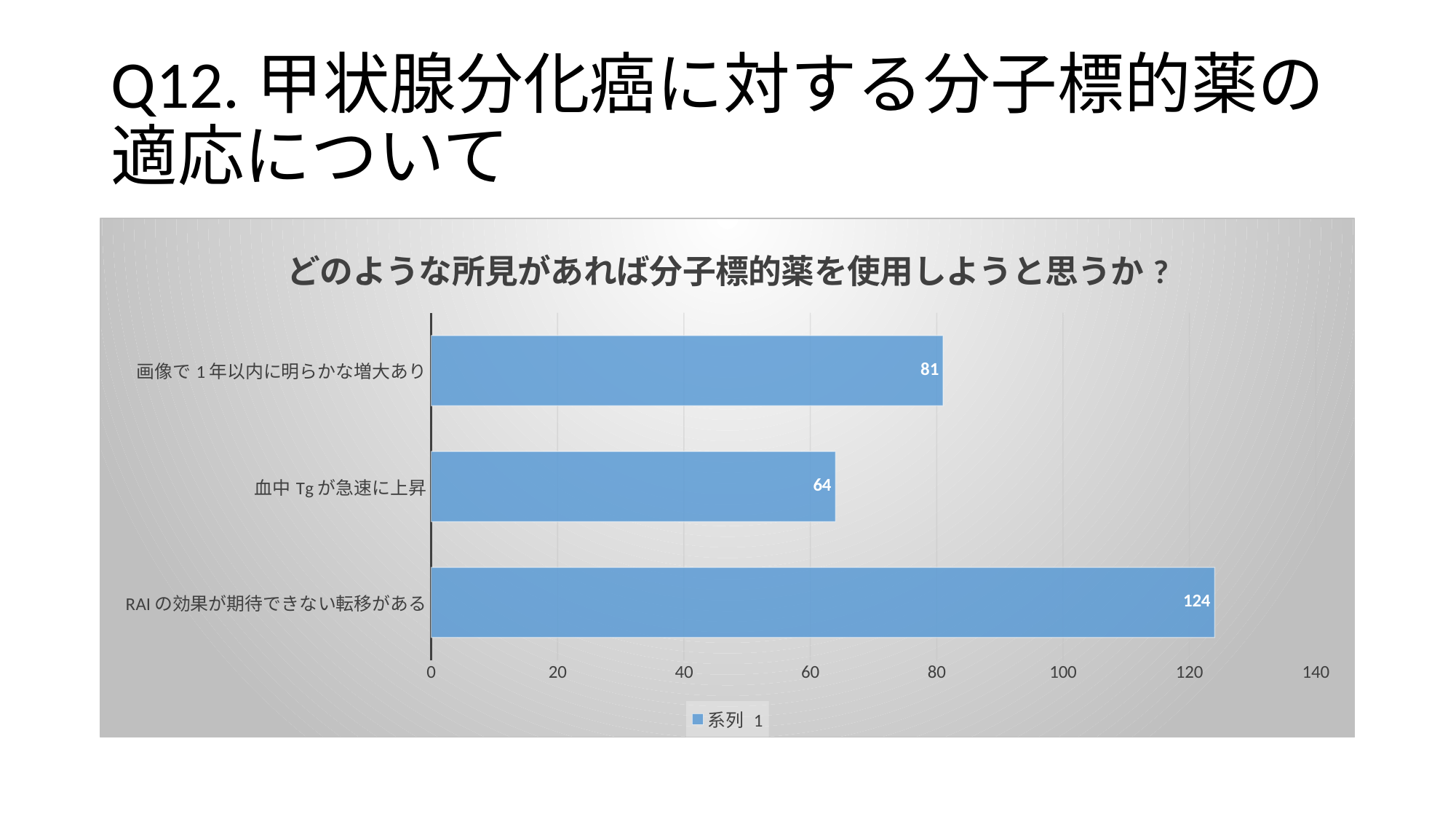
What is the difference between the values for 画像で1年以内に明らかな増大あり and 血中Tgが急速に上昇? 17 What kind of chart is shown on the slide? bar chart What is the difference between the values for RAIの効果が期待できない転移がある and 画像で1年以内に明らかな増大あり? 43 Which category has the lowest value? 血中Tgが急速に上昇 Which category has the highest value? RAIの効果が期待できない転移がある What is the value for 画像で1年以内に明らかな増大あり? 81 How many categories are shown in the chart? 3 What is the value for RAIの効果が期待できない転移がある? 124 What is the value for 血中Tgが急速に上昇? 64 Is the value for RAIの効果が期待できない転移がある greater or less than 100? greater Which is larger, the value for 画像で1年以内に明らかな増大あり or the value for 血中Tgが急速に上昇? 画像で1年以内に明らかな増大あり What is the title of the chart? どのような所見があれば分子標的薬を使用しようと思うか？